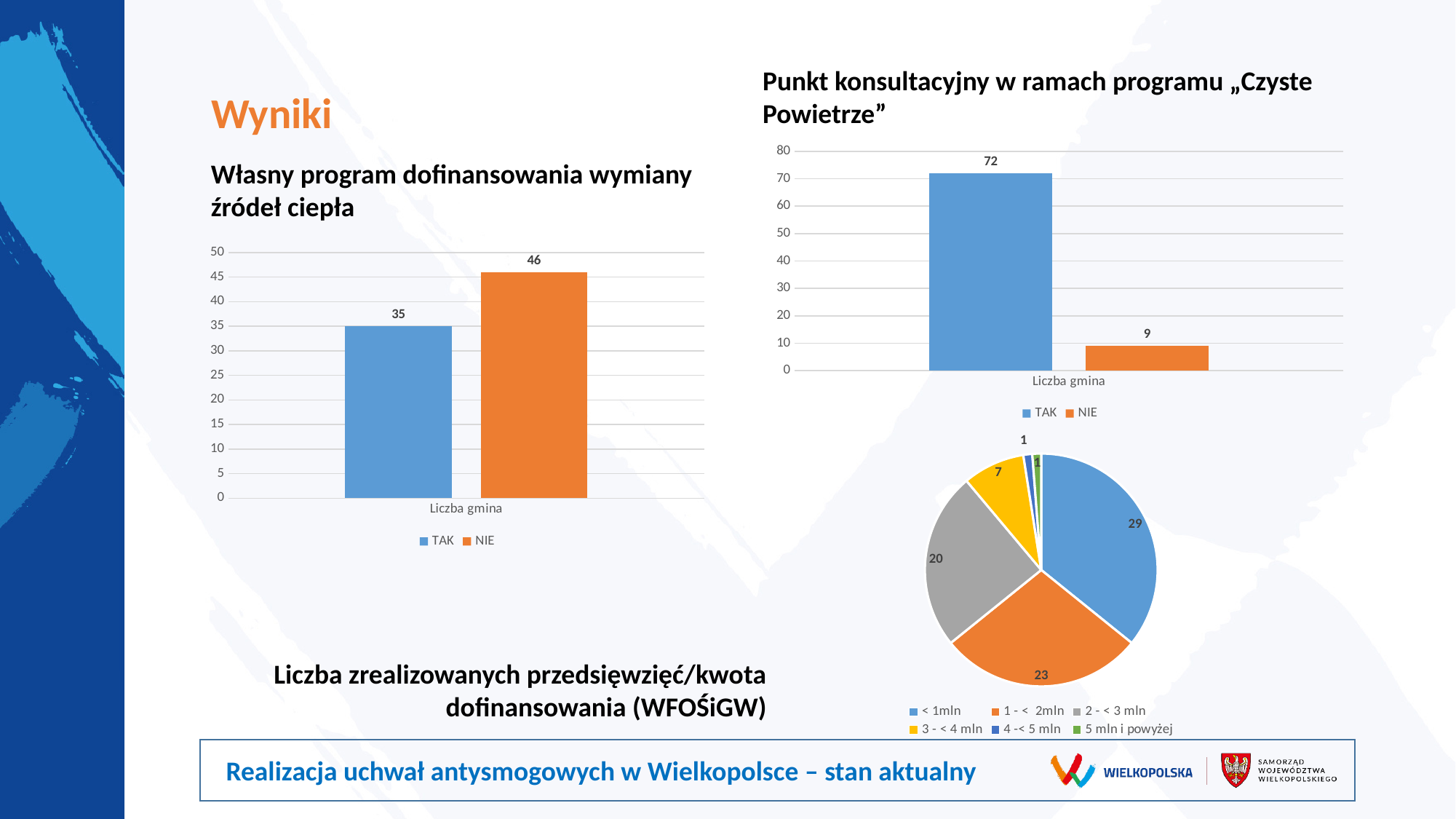
In the chart titled "Punkt konsultacyjny w ramach programu „Czyste Powietrze”", what is the difference between TAK and NIE? 63 In the chart titled "Własny program dofinansowania wymiany źródeł ciepła", what is the value for NIE? 46 In the pie chart titled "Liczba zrealizowanych przedsięwzięć/kwota dofinansowania (WFOŚiGW)", which category has the largest slice? < 1mln What kind of chart is the one titled "Liczba zrealizowanych przedsięwzięć/kwota dofinansowania (WFOŚiGW)"? pie chart In the chart titled "Punkt konsultacyjny w ramach programu „Czyste Powietrze”", what is the value for TAK? 72 In the chart titled "Własny program dofinansowania wymiany źródeł ciepła", what is the value for TAK? 35 In the chart titled "Punkt konsultacyjny w ramach programu „Czyste Powietrze”", what is the value for NIE? 9 In the pie chart titled "Liczba zrealizowanych przedsięwzięć/kwota dofinansowania (WFOŚiGW)", what is the value for the "2 - < 3 mln" slice? 20 In the pie chart titled "Liczba zrealizowanych przedsięwzięć/kwota dofinansowania (WFOŚiGW)", how many categories does the legend list? 6 In the chart titled "Punkt konsultacyjny w ramach programu „Czyste Powietrze”", how many series does the legend list? 2 In the chart titled "Własny program dofinansowania wymiany źródeł ciepła", which series is larger, TAK or NIE? NIE In the chart titled "Własny program dofinansowania wymiany źródeł ciepła", what is the difference between NIE and TAK? 11